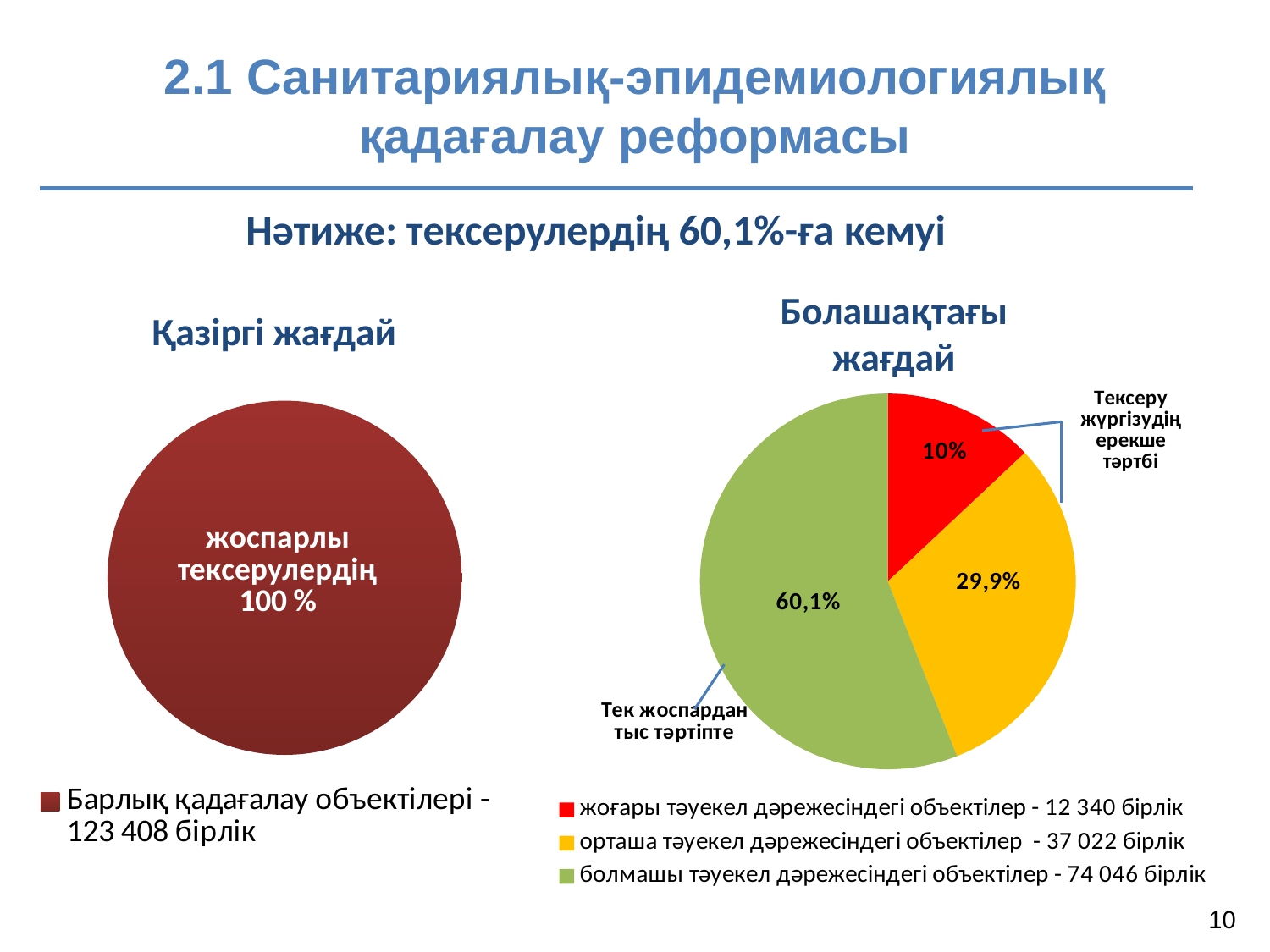
What kind of chart is the "Болашақтағы жағдай" chart? pie chart In the "Болашақтағы жағдай" chart, what is the difference in percentage points between the green slice (60,1%) and the yellow slice (29,9%)? 30,2 In the "Болашақтағы жағдай" chart, what share is labelled on the green slice (болмашы тәуекел дәрежесіндегі объектілер)? 60,1% In the "Болашақтағы жағдай" chart, what share is labelled on the yellow slice (орташа тәуекел дәрежесіндегі объектілер)? 29,9% In the "Болашақтағы жағдай" chart, which category has the smallest slice? жоғары тәуекел дәрежесіндегі объектілер In the "Болашақтағы жағдай" chart, which slice is larger: орташа тәуекел or жоғары тәуекел? орташа тәуекел In the "Болашақтағы жағдай" chart, what share is labelled on the red slice (жоғары тәуекел дәрежесіндегі объектілер)? 10% In the "Қазіргі жағдай" chart, how many entries does the legend list? 1 In the "Болашақтағы жағдай" chart, which category has the largest slice? болмашы тәуекел дәрежесіндегі объектілер In the "Болашақтағы жағдай" chart, how many slices does the pie have? 3 In the "Болашақтағы жағдай" chart, what colour is the slice for болмашы тәуекел дәрежесіндегі объектілер? green